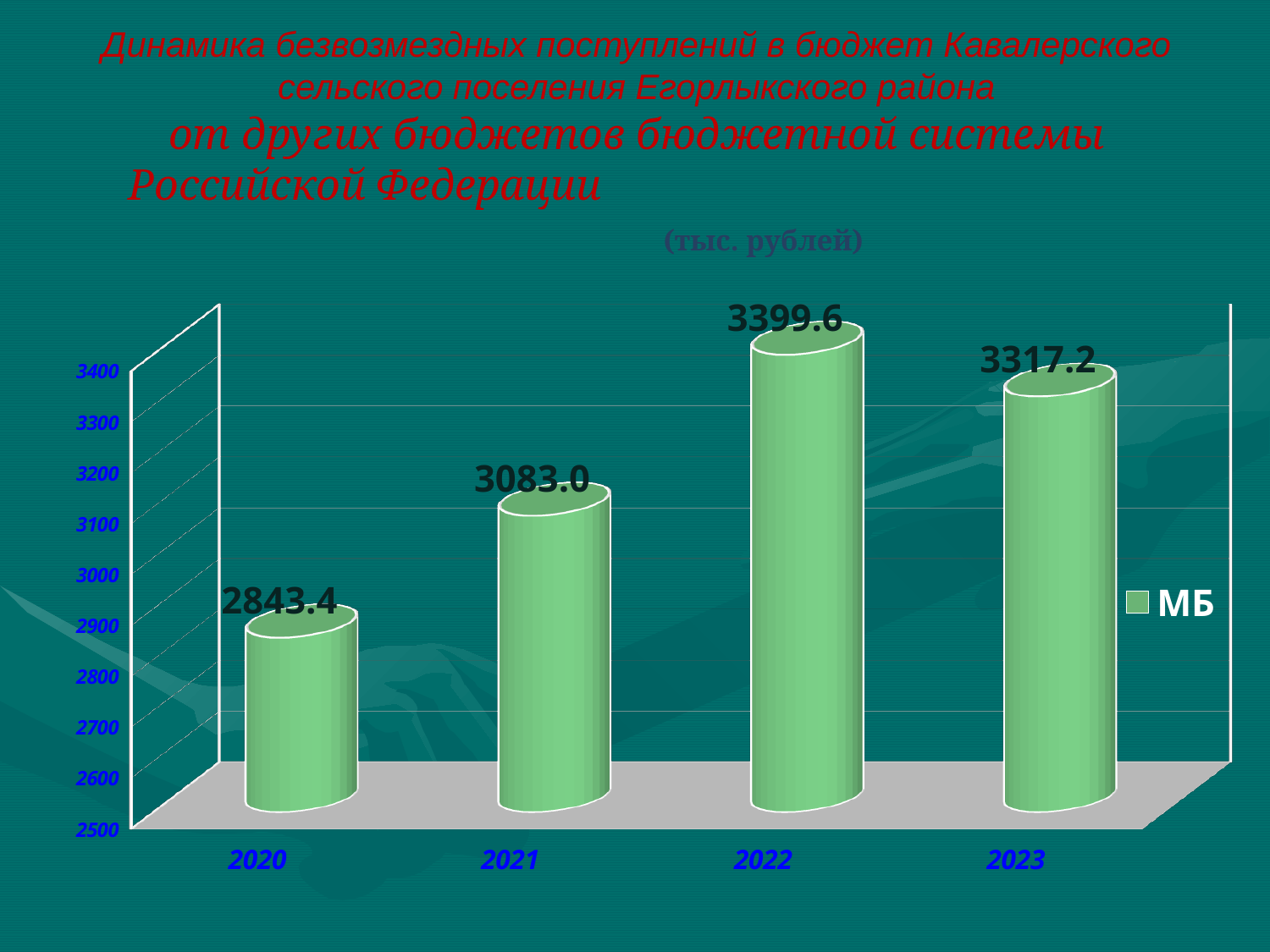
What is the value for 2020? 2843.4 Which year has the lowest value? 2020 How many years are shown on the x axis? 4 What is the value for 2021? 3083.0 What kind of chart is shown on the slide? bar chart What is the value for 2022? 3399.6 Which is larger, the value for 2021 or the value for 2023? 2023 What is the value for 2023? 3317.2 Which year has the highest value? 2022 How many series does the legend list? 1 What is the difference between the values for 2021 and 2020? 239.6 What is the difference between the values for 2022 and 2023? 82.4